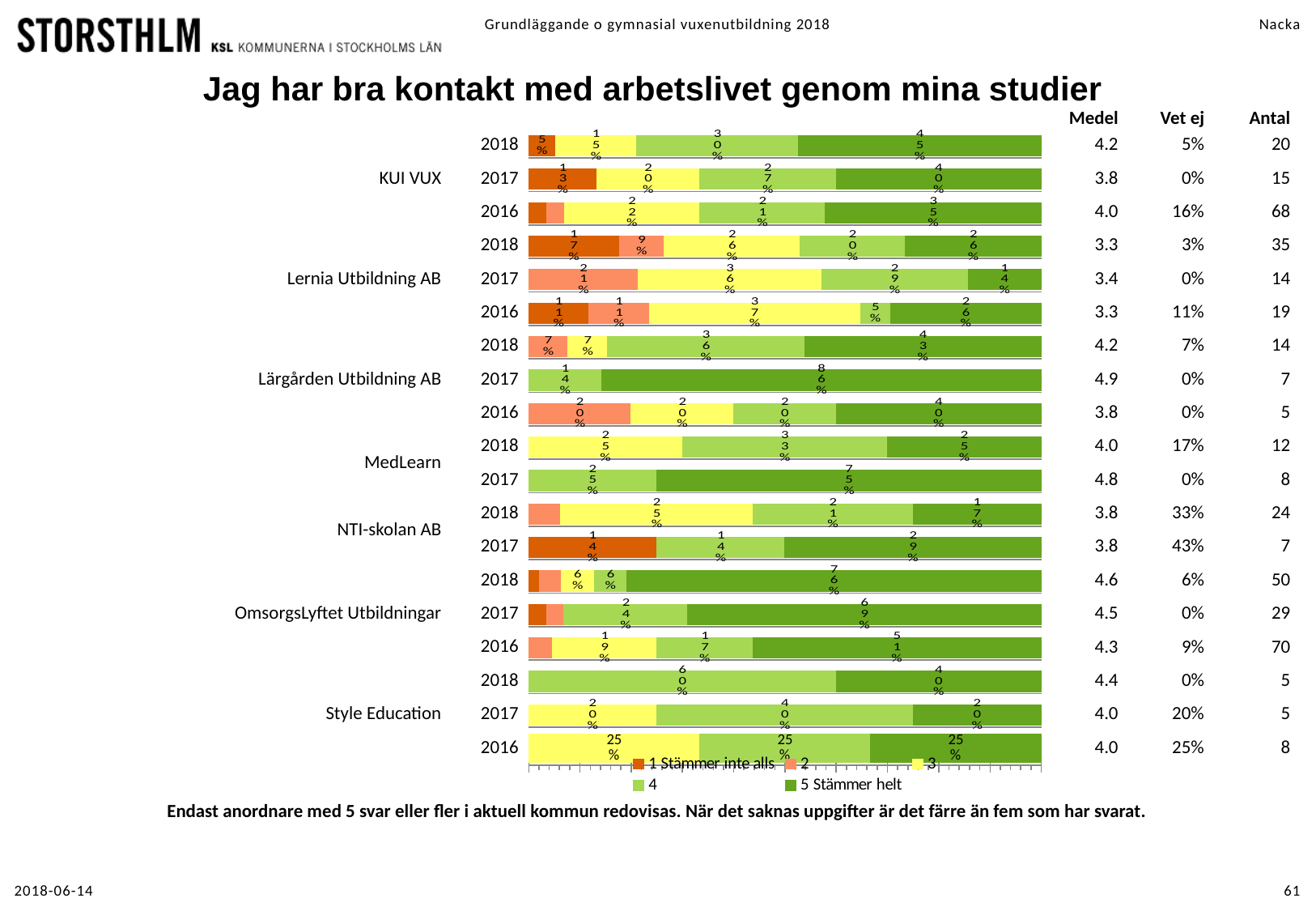
How many series does the legend list? 5 How many education providers (anordnare) are listed in the chart? 7 What percentage of Lärgården Utbildning AB respondents in 2017 answered '5 Stämmer helt'? 86% Which provider and year has the highest Medel value? Lärgården Utbildning AB 2017 What percentage of OmsorgsLyftet Utbildningar respondents in 2018 answered '5 Stämmer helt'? 76% What kind of chart is shown on the slide? bar chart What percentage of MedLearn respondents in 2017 answered '5 Stämmer helt'? 75% What percentage of Style Education respondents in 2018 answered '4'? 60% What is the Antal value for OmsorgsLyftet Utbildningar in 2016? 70 What percentage of Style Education respondents in 2016 answered '3'? 25% Which has the larger share of '5 Stämmer helt': Lärgården Utbildning AB 2017 or MedLearn 2017? Lärgården Utbildning AB 2017 What percentage of Lärgården Utbildning AB respondents in 2017 answered '4'? 14%